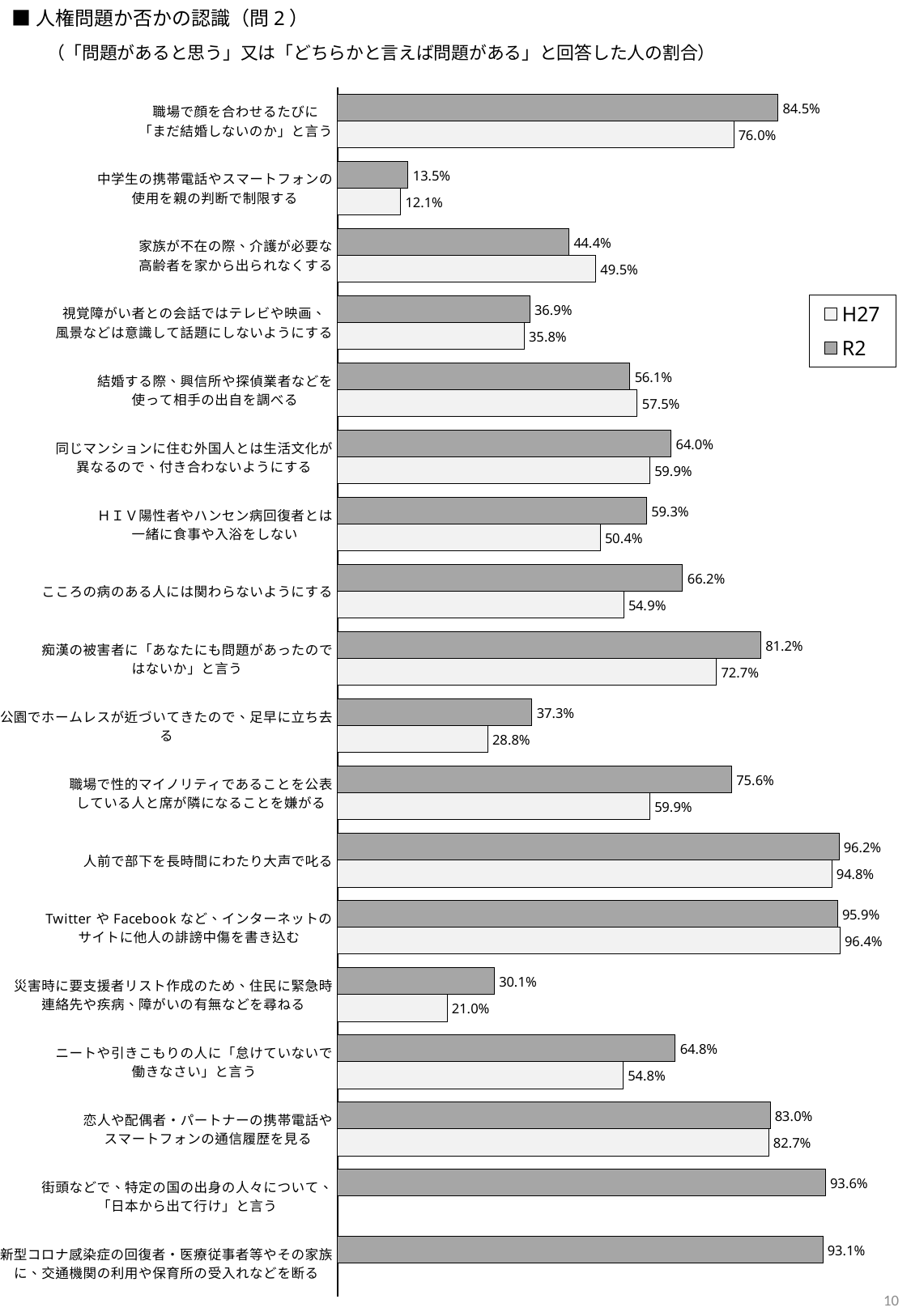
What is the difference between the R2 and H27 values for 「災害時に要支援者リスト作成のため、住民に緊急時連絡先や疾病、障がいの有無などを尋ねる」? 9.1% What is the difference between the R2 and H27 values for 「職場で性的マイノリティであることを公表している人と席が隣になることを嫌がる」? 15.7% What kind of chart is shown on the slide? Bar chart What is the H27 value for 「こころの病のある人には関わらないようにする」? 54.9% How many series does the legend list? 2 What is the R2 value for 「人前で部下を長時間にわたり大声で叱る」? 96.2% Which category has the lowest R2 value? 中学生の携帯電話やスマートフォンの使用を親の判断で制限する Which category has the highest H27 value? Twitter や Facebook など、インターネットのサイトに他人の誹謗中傷を書き込む How many categories are shown in the chart? 18 Which series is shown with the darker grey bars in the legend? R2 What is the R2 value for 「新型コロナ感染症の回復者・医療従事者等やその家族に、交通機関の利用や保育所の受入れなどを断る」? 93.1% For 「家族が不在の際、介護が必要な高齢者を家から出られなくする」, which is larger, the H27 value or the R2 value? H27